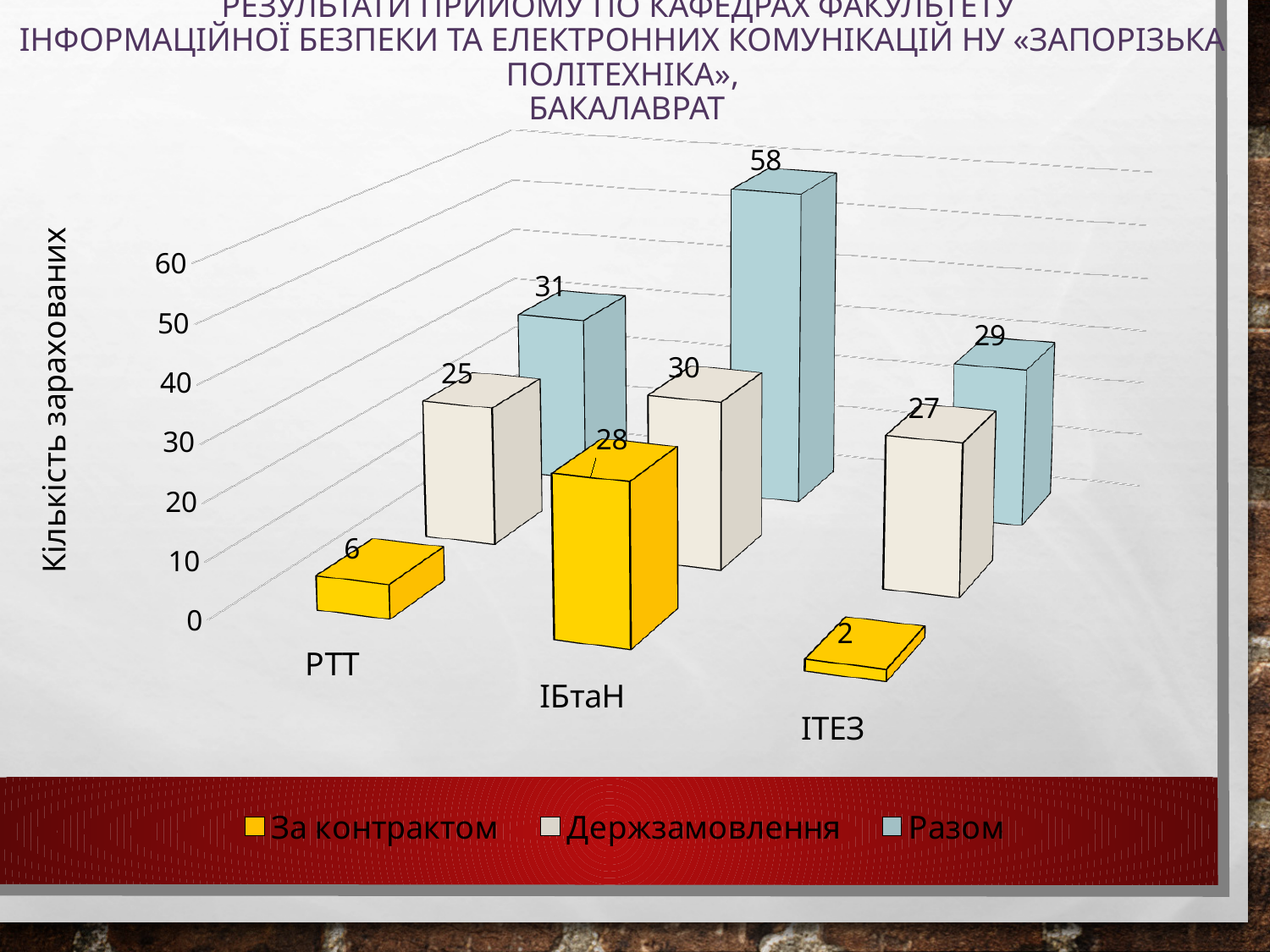
What kind of chart is shown on the slide? bar chart Which series is shown in blue in the legend? Разом How many series does the legend list? 3 What is the value of Держзамовлення for ІТЕЗ? 27 What is the label of the vertical axis? Кількість зарахованих Which is larger: Держзамовлення for РТТ or Держзамовлення for ІБтаН? ІБтаН What is the difference between the Разом values for ІБтаН and ІТЕЗ? 29 What is the value of За контрактом for ІБтаН? 28 Which category has the highest Разом value? ІБтаН Which category has the lowest За контрактом value? ІТЕЗ How many categories are shown on the x axis? 3 What is the value of Разом for РТТ? 31